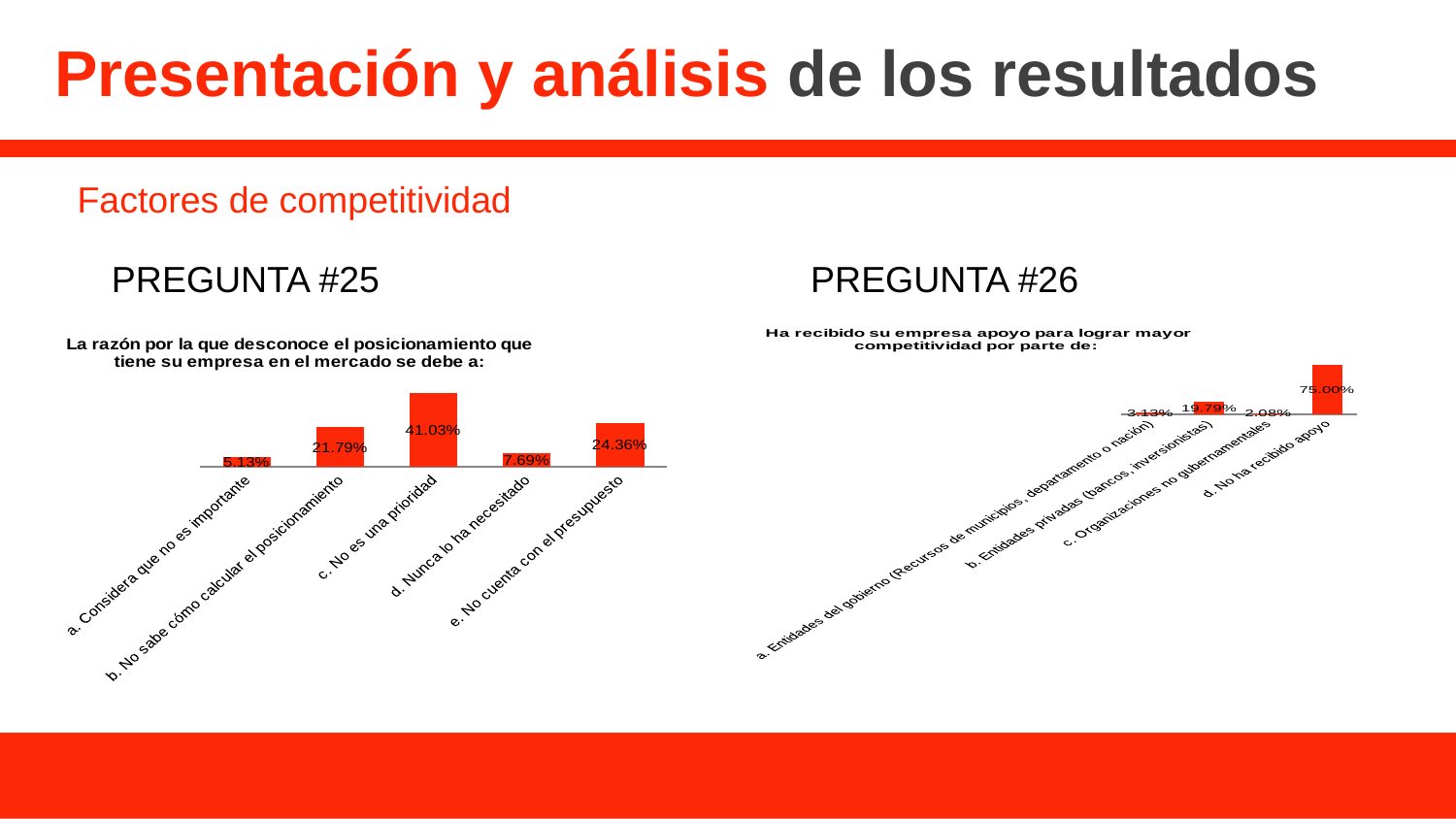
In the PREGUNTA #25 chart, what is the value for 'c. No es una prioridad'? 41.03% In the PREGUNTA #26 chart, which is larger: 'a. Entidades del gobierno' or 'b. Entidades privadas'? b. Entidades privadas What type of chart is used for PREGUNTA #25? Bar chart In the PREGUNTA #25 chart, how many categories are shown? 5 In the PREGUNTA #25 chart, which category has the lowest value? a. Considera que no es importante In the PREGUNTA #26 chart, how many categories are shown? 4 In the PREGUNTA #25 chart, what is the value for 'e. No cuenta con el presupuesto'? 24.36% In the PREGUNTA #26 chart, what is the value for 'd. No ha recibido apoyo'? 75.00% In the PREGUNTA #26 chart, what is the value for 'b. Entidades privadas (bancos, inversionistas)'? 19.79% In the PREGUNTA #26 chart, which category has the lowest value? c. Organizaciones no gubernamentales In the PREGUNTA #25 chart, which category has the highest value? c. No es una prioridad In the PREGUNTA #25 chart, what is the difference between 'c. No es una prioridad' and 'b. No sabe cómo calcular el posicionamiento'? 19.24%